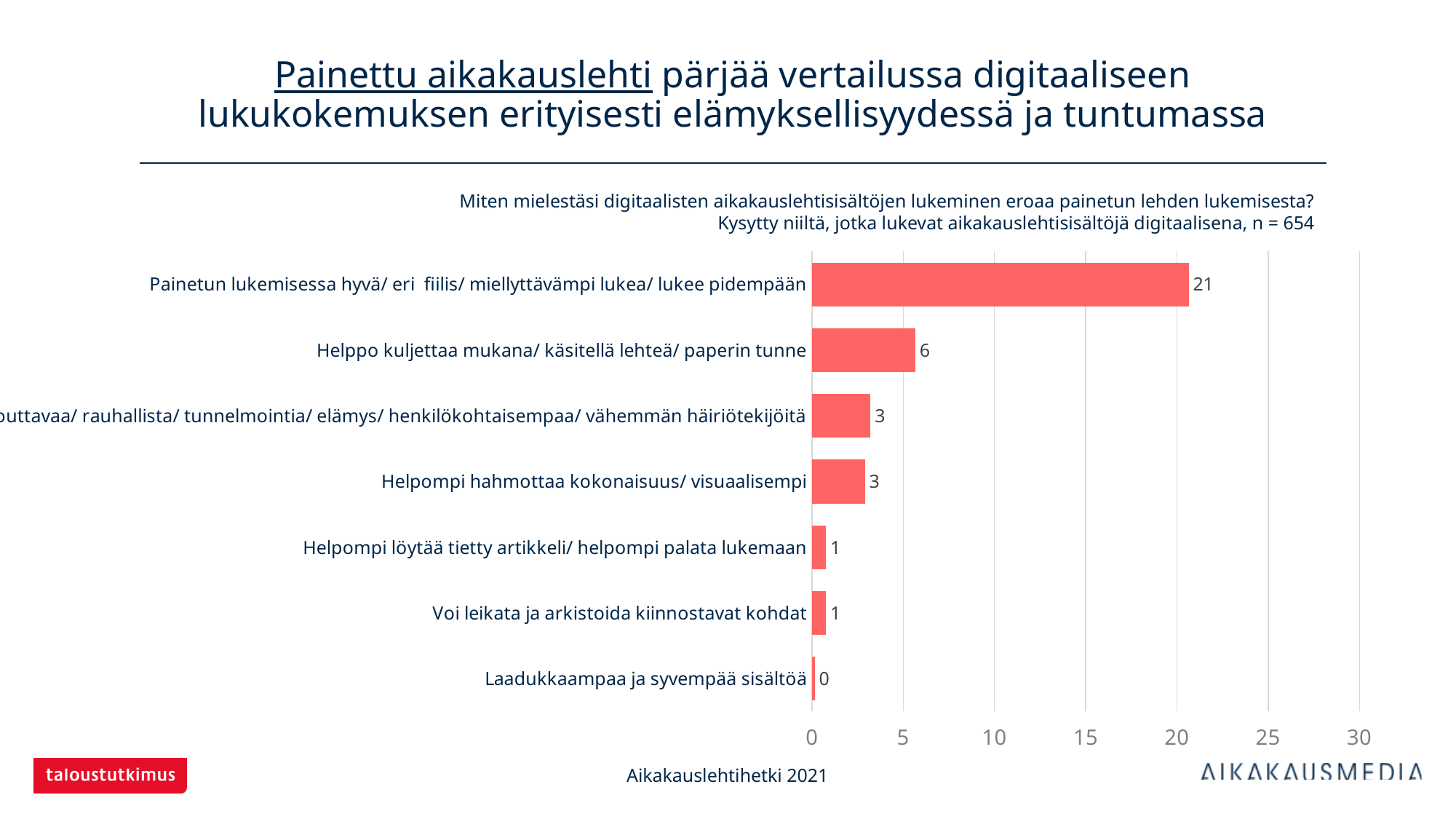
What kind of chart is shown on the slide? bar chart Which category has the lowest value? Laadukkaampaa ja syvempää sisältöä Is the value for "Painetun lukemisessa hyvä/ eri fiilis/ miellyttävämpi lukea/ lukee pidempään" greater or less than 20? greater What is the difference between the values for "Painetun lukemisessa hyvä/ eri fiilis/ miellyttävämpi lukea/ lukee pidempään" and "Helppo kuljettaa mukana/ käsitellä lehteä/ paperin tunne"? 15 What is the value for "Painetun lukemisessa hyvä/ eri fiilis/ miellyttävämpi lukea/ lukee pidempään"? 21 What is the value for "Helpompi hahmottaa kokonaisuus/ visuaalisempi"? 3 What is the value for "Helppo kuljettaa mukana/ käsitellä lehteä/ paperin tunne"? 6 What is the value for "Laadukkaampaa ja syvempää sisältöä"? 0 How many categories are shown in the chart? 7 What is the value for "Voi leikata ja arkistoida kiinnostavat kohdat"? 1 Which is larger: the value for "Helppo kuljettaa mukana/ käsitellä lehteä/ paperin tunne" or for "Helpompi hahmottaa kokonaisuus/ visuaalisempi"? Helppo kuljettaa mukana/ käsitellä lehteä/ paperin tunne Which category has the highest value? Painetun lukemisessa hyvä/ eri fiilis/ miellyttävämpi lukea/ lukee pidempään